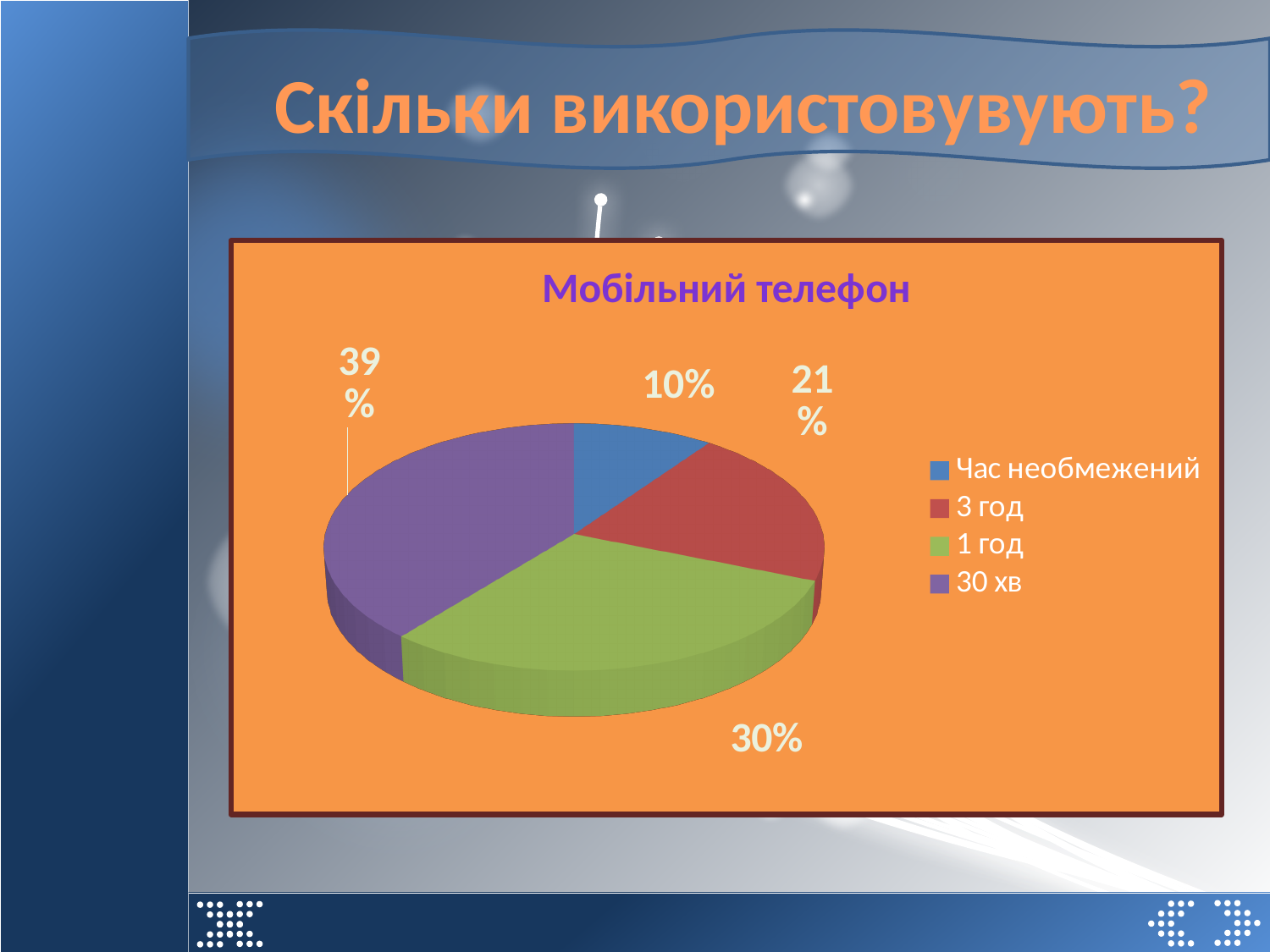
What is the title of the chart? Мобільний телефон What type of chart is shown on the slide? pie chart Which category has the largest slice of the pie? 30 хв What share of the pie is labelled for 'Час необмежений'? 10% How many entries does the legend list? 4 Which category has the smallest slice of the pie? Час необмежений Which is larger, the share for '3 год' or the share for '1 год'? 1 год How many slices does the pie chart have? 4 What share of the pie is labelled for '30 хв'? 39% What share of the pie is labelled for '1 год'? 30% What is the difference in percentage points between '30 хв' and '1 год'? 9